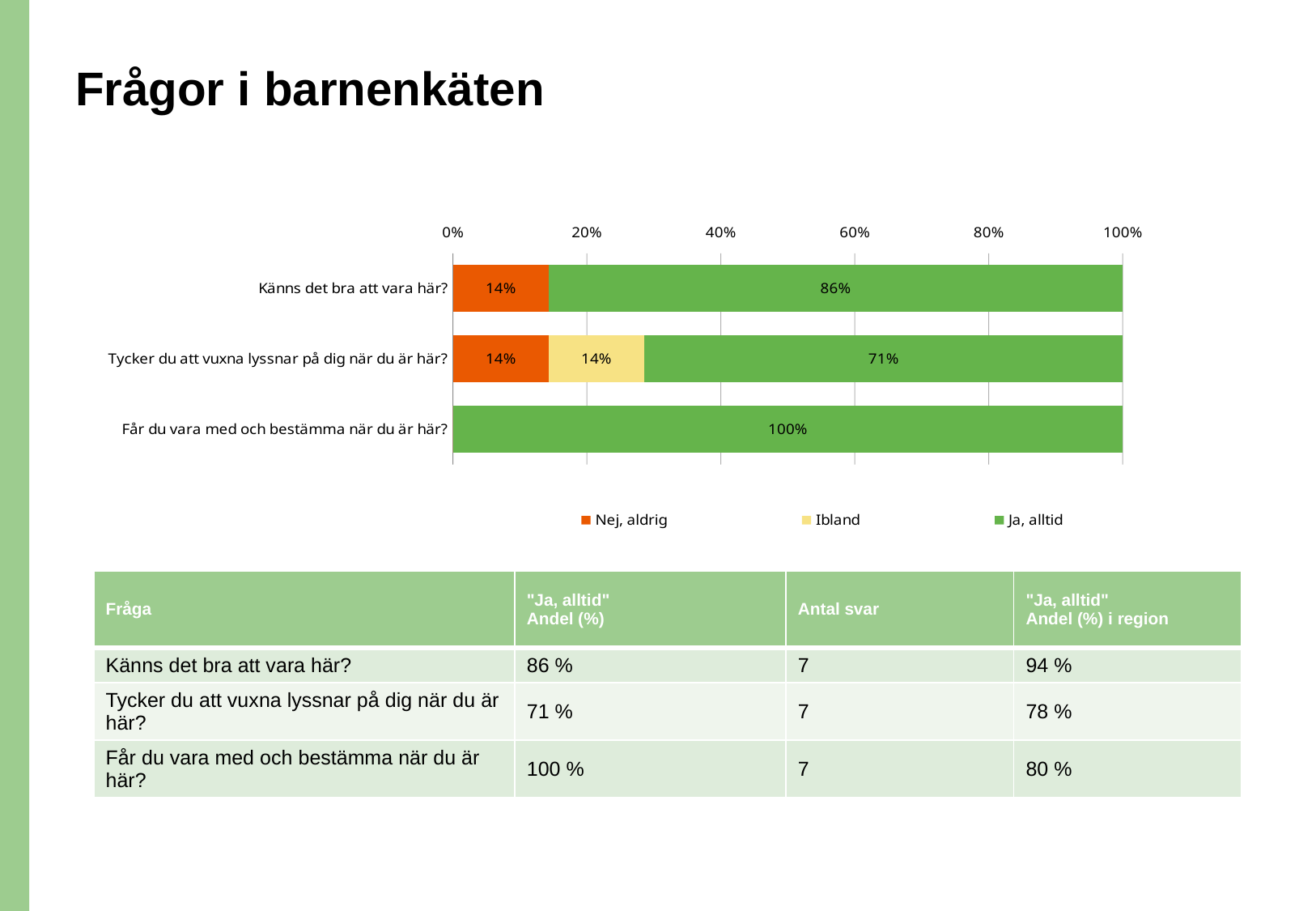
How many questions (categories) are shown in the chart? 3 How many series does the legend list? 3 What is the "Ja, alltid" value for "Känns det bra att vara här?"? 86% Which question has the highest "Ja, alltid" value? Får du vara med och bestämma när du är här? Which legend entry is shown in orange? Nej, aldrig Which is larger: the "Ja, alltid" value for "Känns det bra att vara här?" or for "Tycker du att vuxna lyssnar på dig när du är här?"? Känns det bra att vara här? What is the difference between the "Ja, alltid" values for "Känns det bra att vara här?" and "Tycker du att vuxna lyssnar på dig när du är här?"? 15% What kind of chart is shown on the slide? Stacked bar chart What is the "Nej, aldrig" value for "Känns det bra att vara här?"? 14% What is the "Ibland" value for "Tycker du att vuxna lyssnar på dig när du är här?"? 14% What is the "Ja, alltid" value for "Får du vara med och bestämma när du är här?"? 100% Which question has the lowest "Ja, alltid" value? Tycker du att vuxna lyssnar på dig när du är här?